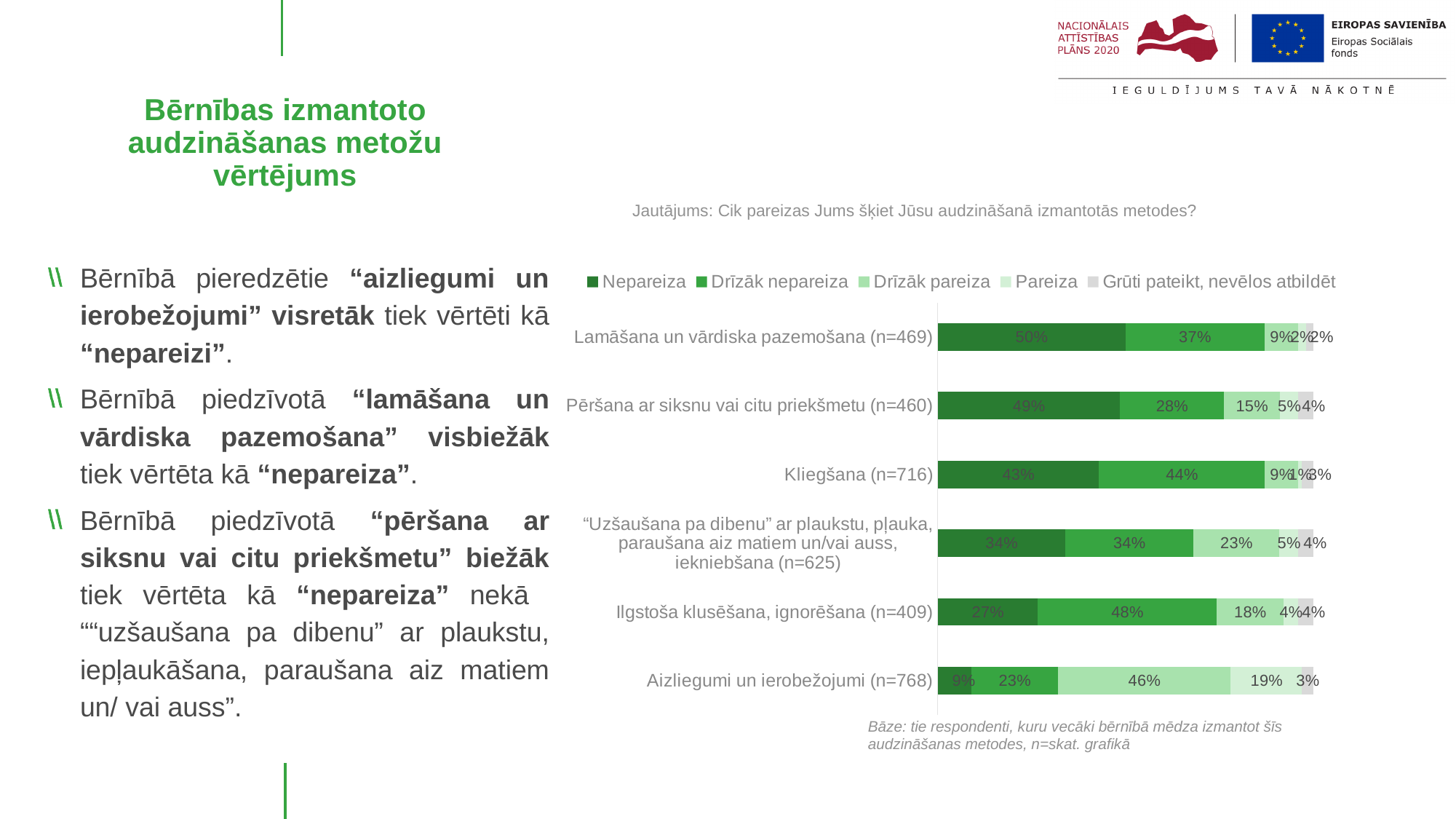
What is the difference between the "Nepareiza" values for "Pēršana ar siksnu vai citu priekšmetu (n=460)" and "Ilgstoša klusēšana, ignorēšana (n=409)"? 22% Which category has the lowest "Nepareiza" value? Aizliegumi un ierobežojumi (n=768) What is the "Drīzāk pareiza" value for "Aizliegumi un ierobežojumi (n=768)"? 46% What is the "Drīzāk nepareiza" value for "Ilgstoša klusēšana, ignorēšana (n=409)"? 48% What is the last entry listed in the chart legend? Grūti pateikt, nevēlos atbildēt How many series does the legend list? 5 What is the "Nepareiza" value for "Lamāšana un vārdiska pazemošana (n=469)"? 50% Which is larger: the "Pareiza" value for "Aizliegumi un ierobežojumi (n=768)" or for "Pēršana ar siksnu vai citu priekšmetu (n=460)"? Aizliegumi un ierobežojumi (n=768) What kind of chart is shown on the slide? stacked bar chart How many categories (parenting methods) are shown in the chart? 6 Which category has the highest "Nepareiza" value? Lamāšana un vārdiska pazemošana (n=469) What is the "Drīzāk pareiza" value for "Pēršana ar siksnu vai citu priekšmetu (n=460)"? 15%